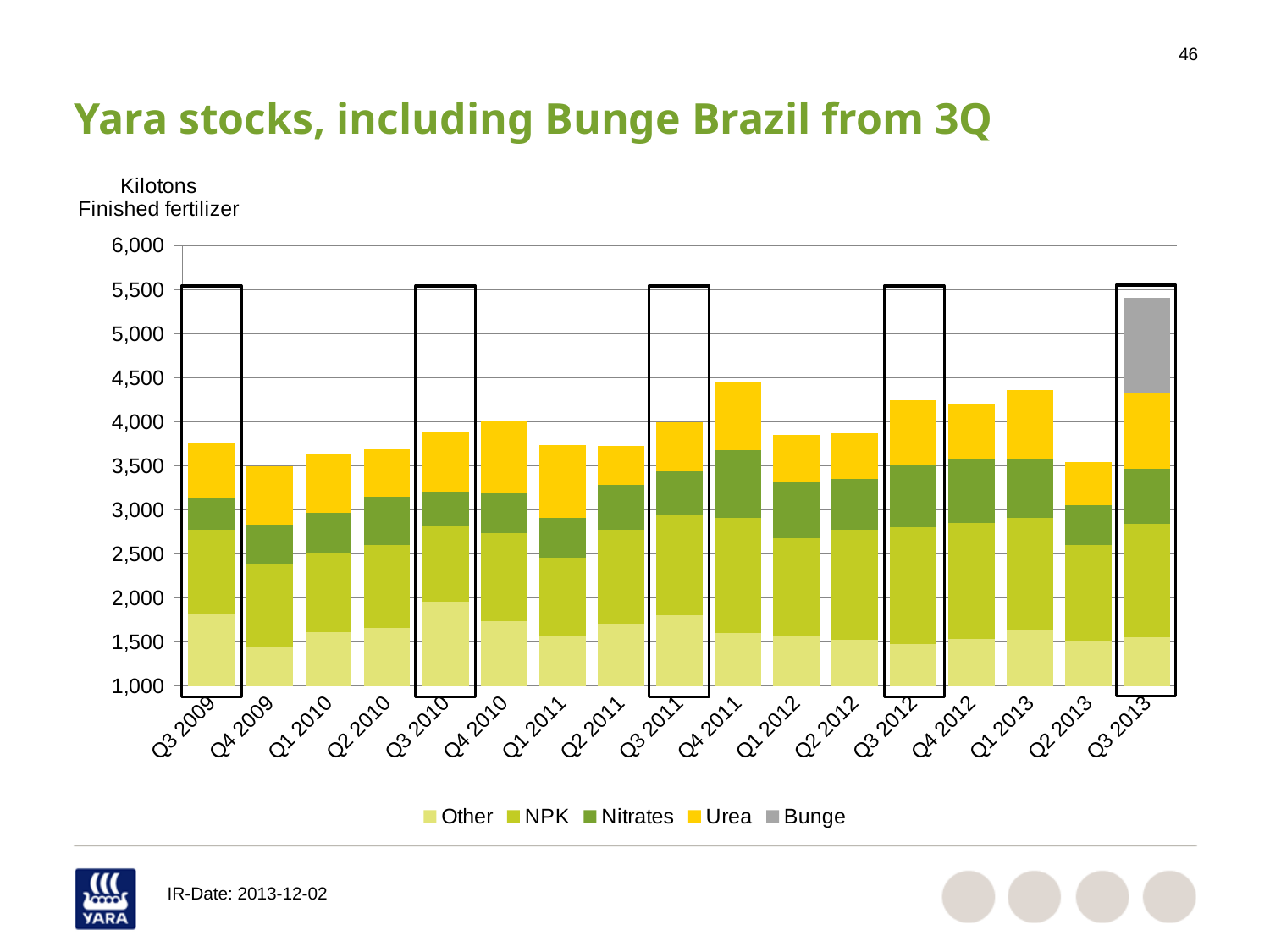
Is the total stock for Q3 2009 greater or less than 4,000 kilotons? less Is the total stock for Q3 2013 greater or less than 5,000 kilotons? greater Which quarter has the larger total stock bar, Q4 2011 or Q1 2012? Q4 2011 How many series does the legend list? 5 Which series appears only in the Q3 2013 bar? Bunge What unit is given for the y axis of the chart? Kilotons Finished fertilizer Which quarter has the highest total stock bar? Q3 2013 What kind of chart is shown on the slide? Stacked bar chart Is the total stock for Q4 2009 greater or less than 4,000 kilotons? less How many quarters are shown on the x axis of the chart? 17 Which quarter has the larger total stock bar, Q3 2012 or Q3 2013? Q3 2013